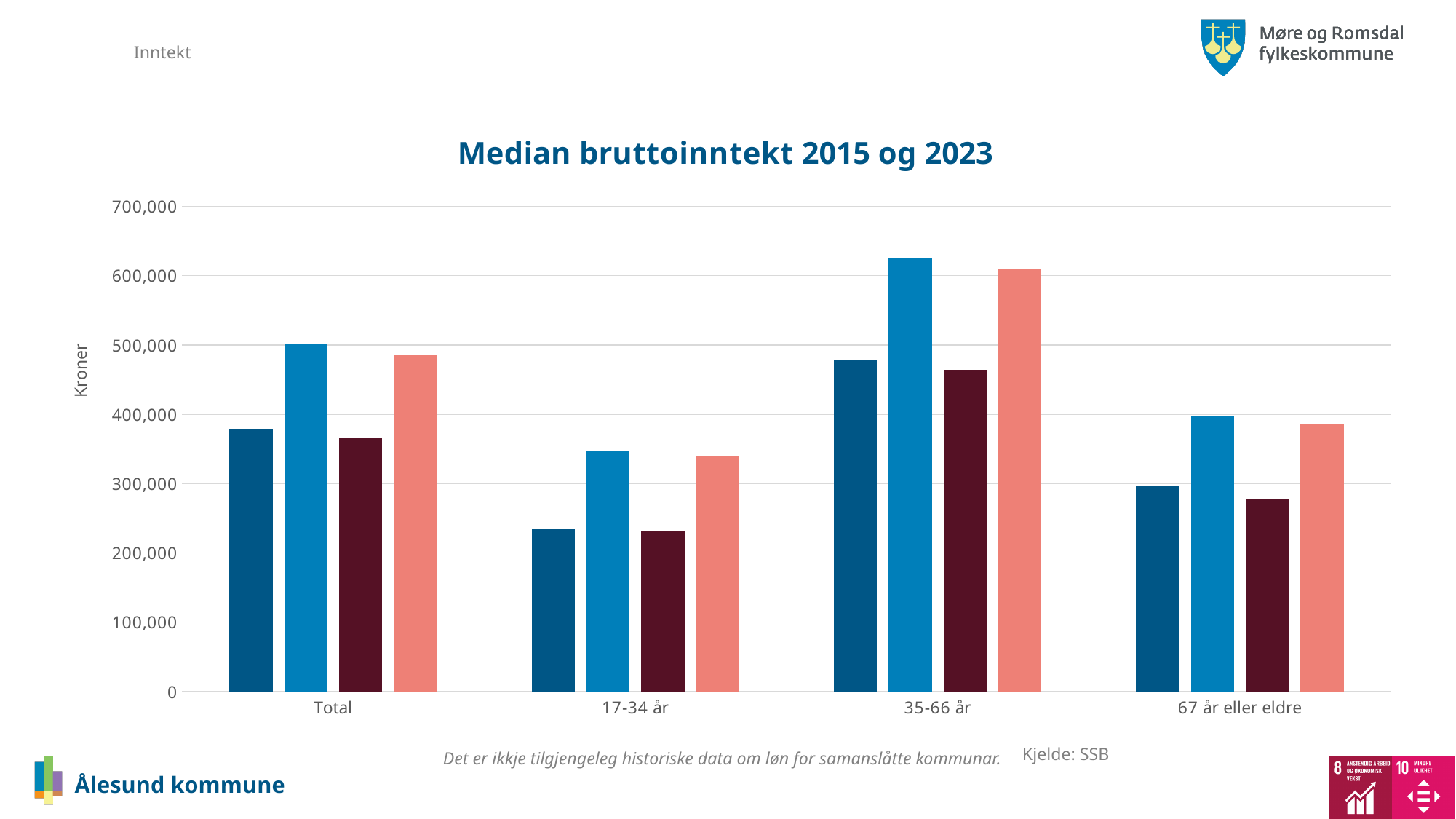
Is the value of the light blue bar for 35-66 år greater or less than 600,000? greater How many age-group categories are shown along the x axis? 4 What type of chart is shown on the slide? bar chart Is the value of the dark blue bar for 17-34 år greater or less than 200,000? greater Is the value of the dark blue bar for Total greater or less than 400,000? less What is the label on the vertical axis of the chart? Kroner What is the title of the chart? Median bruttoinntekt 2015 og 2023 Which category has the tallest light blue bar? 35-66 år Which is larger: the dark red bar for Total or the dark red bar for 67 år eller eldre? Total Which is larger: the salmon bar for 17-34 år or the salmon bar for 67 år eller eldre? 67 år eller eldre Which category has the shortest dark blue bar? 17-34 år